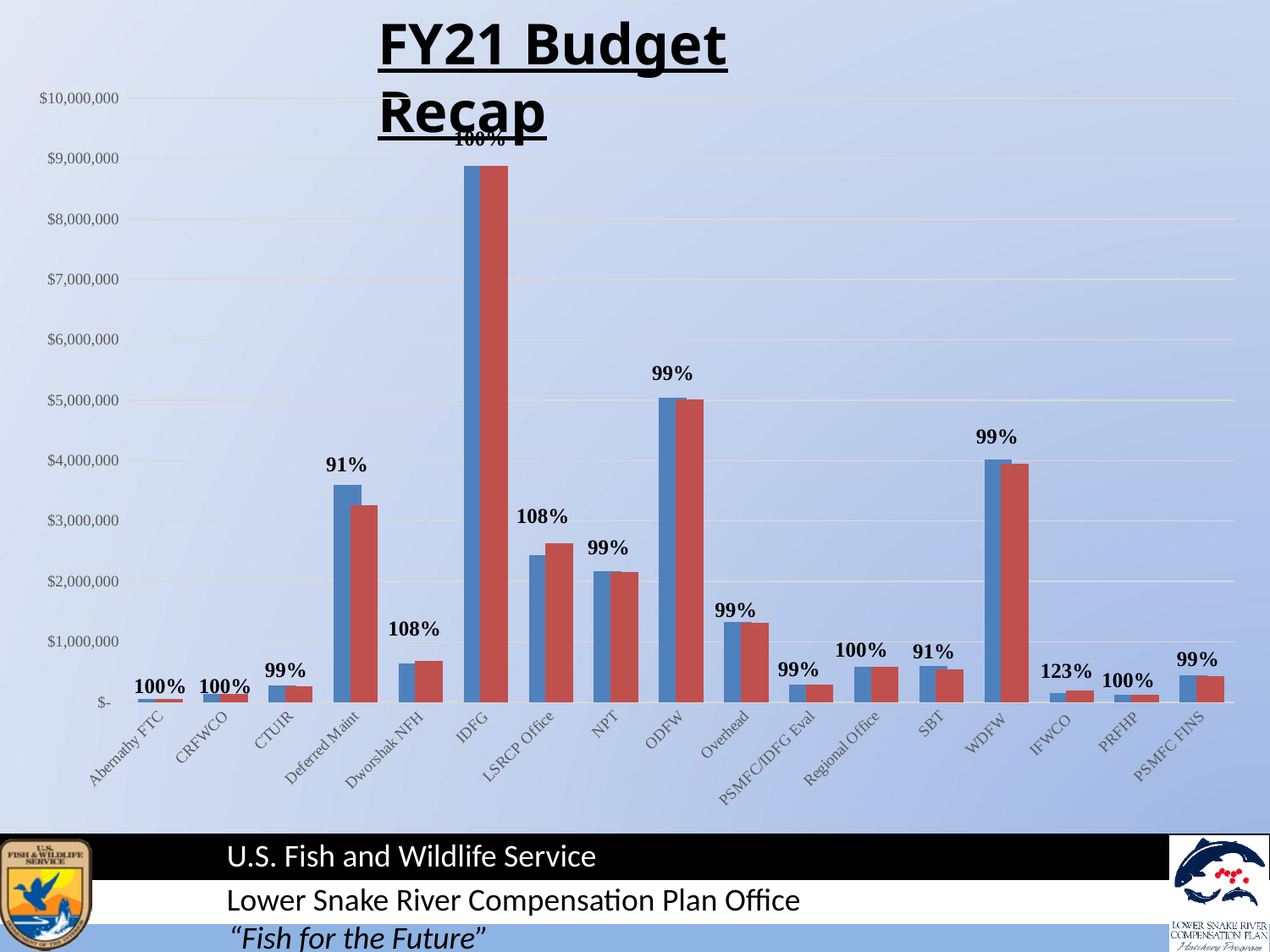
What percentage label is shown above the WDFW bars? 99% How many categories are shown along the x axis of the chart? 17 What percentage label is shown above the Deferred Maint bars? 91% Is the value of the blue bar for WDFW greater or less than $3,000,000? greater What percentage label is shown above the IFWCO bars? 123% Is the value of the blue bar for IDFG greater or less than $8,000,000? greater What is the title of the chart? FY21 Budget Recap What percentage label is shown above the LSRCP Office bars? 108% Which category has larger bars, Deferred Maint or NPT? Deferred Maint Which category has the tallest bars in the chart? IDFG What kind of chart is shown on the slide? bar chart Which category has the highest percentage label in the chart? IFWCO